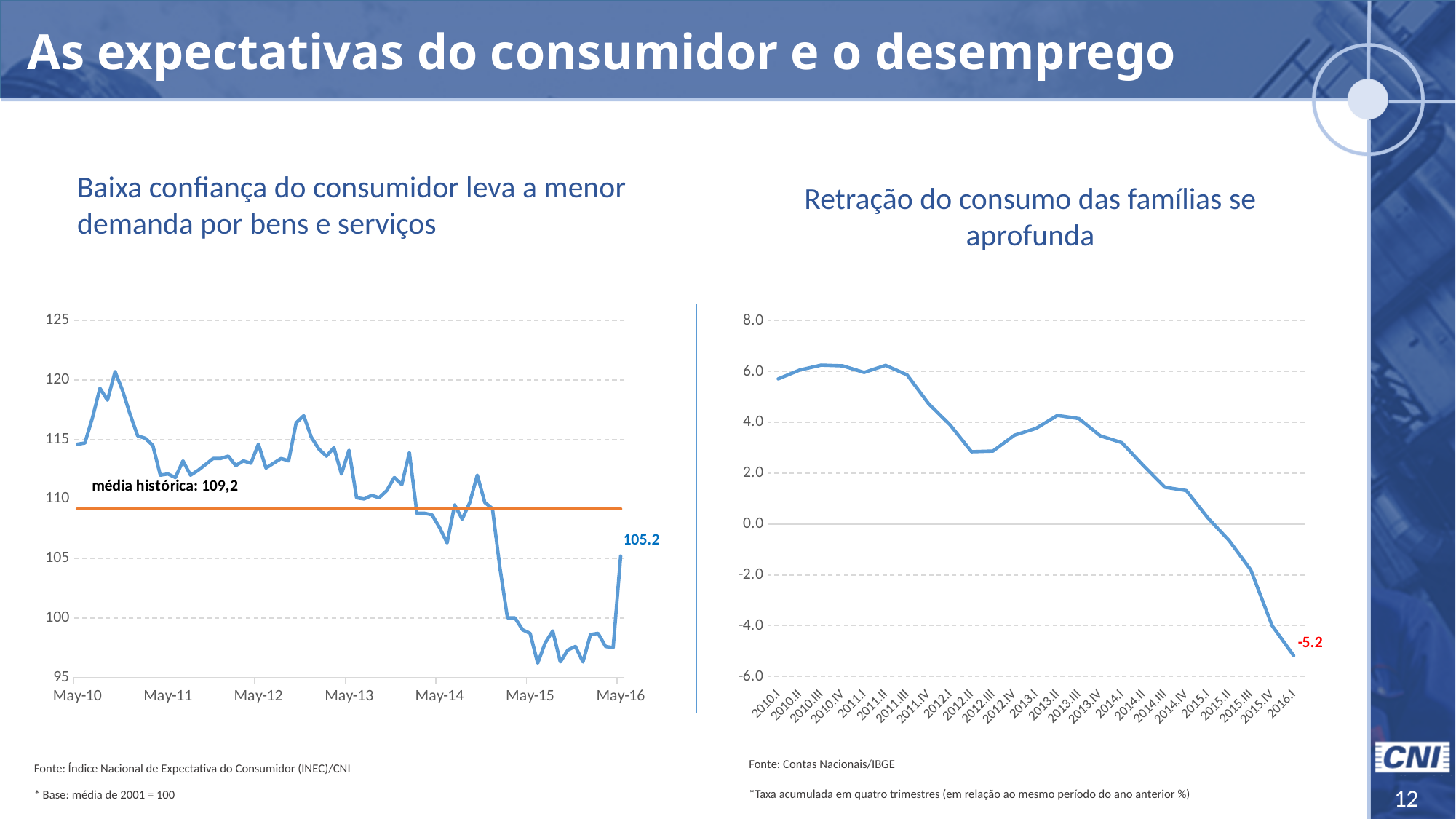
On the right chart, how many quarters are shown on the x axis? 25 On the left chart (Baixa confiança do consumidor), what is the value labelled at May-16? 105.2 What kind of chart is the right chart (Retração do consumo das famílias se aprofunda)? line chart On the left chart, do the values overall rise or fall from May-10 to May-16? fall On the right chart, is the value for 2010.I greater or less than 4.0? greater On the left chart, what is the value of the média histórica shown by the orange line? 109,2 On the left chart, is the value at May-10 greater or less than 110? greater On the right chart (Retração do consumo das famílias se aprofunda), what is the value labelled at 2016.I? -5.2 On the right chart, which quarter has the lowest value? 2016.I On the right chart, do the values overall rise or fall from 2010.I to 2016.I? fall What kind of chart is the left chart (Baixa confiança do consumidor)? line chart On the left chart, is the May-16 value (105.2) larger or smaller than the média histórica (109,2)? smaller